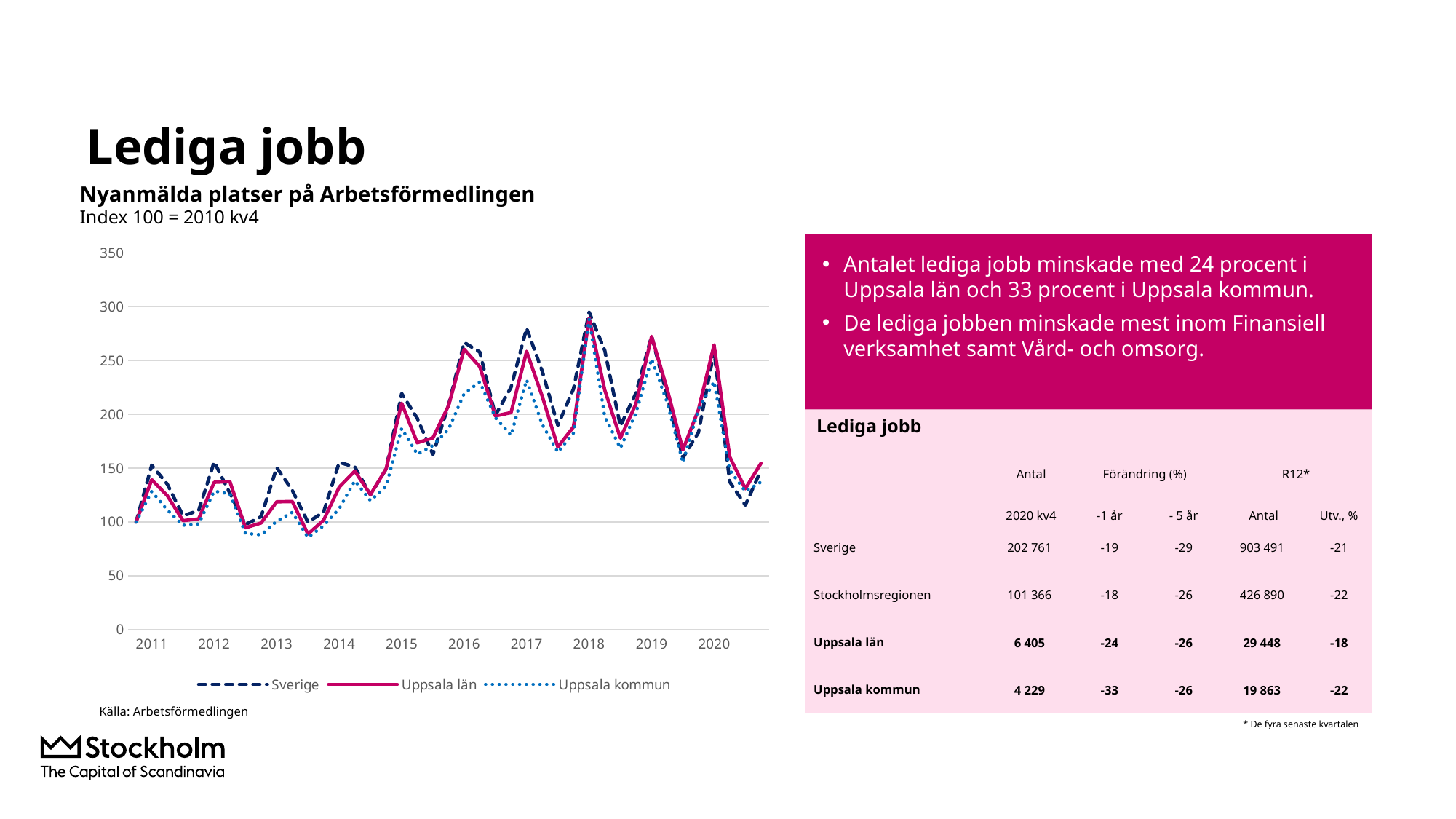
Do the values for Uppsala län rise or fall from the 2018 peak to the end of 2020? fall Which series are listed in the chart legend? Sverige, Uppsala län, Uppsala kommun In which year does the Sverige series reach its highest peak? 2018 Is the lowest value for Uppsala kommun around 2013 greater or less than 100? less What is the subtitle of the chart above the plot area? Nyanmälda platser på Arbetsförmedlingen How many year labels are shown on the x axis of the chart? 10 At the 2017 peak, which series is higher: Sverige or Uppsala kommun? Sverige How many series does the chart legend list? 3 Is the peak value for Sverige in 2018 greater or less than 250? greater Do the values for Sverige generally rise or fall from 2011 to 2018? rise What kind of chart is shown on the slide? line chart Is the peak value for Uppsala kommun in 2016 greater or less than 250? less